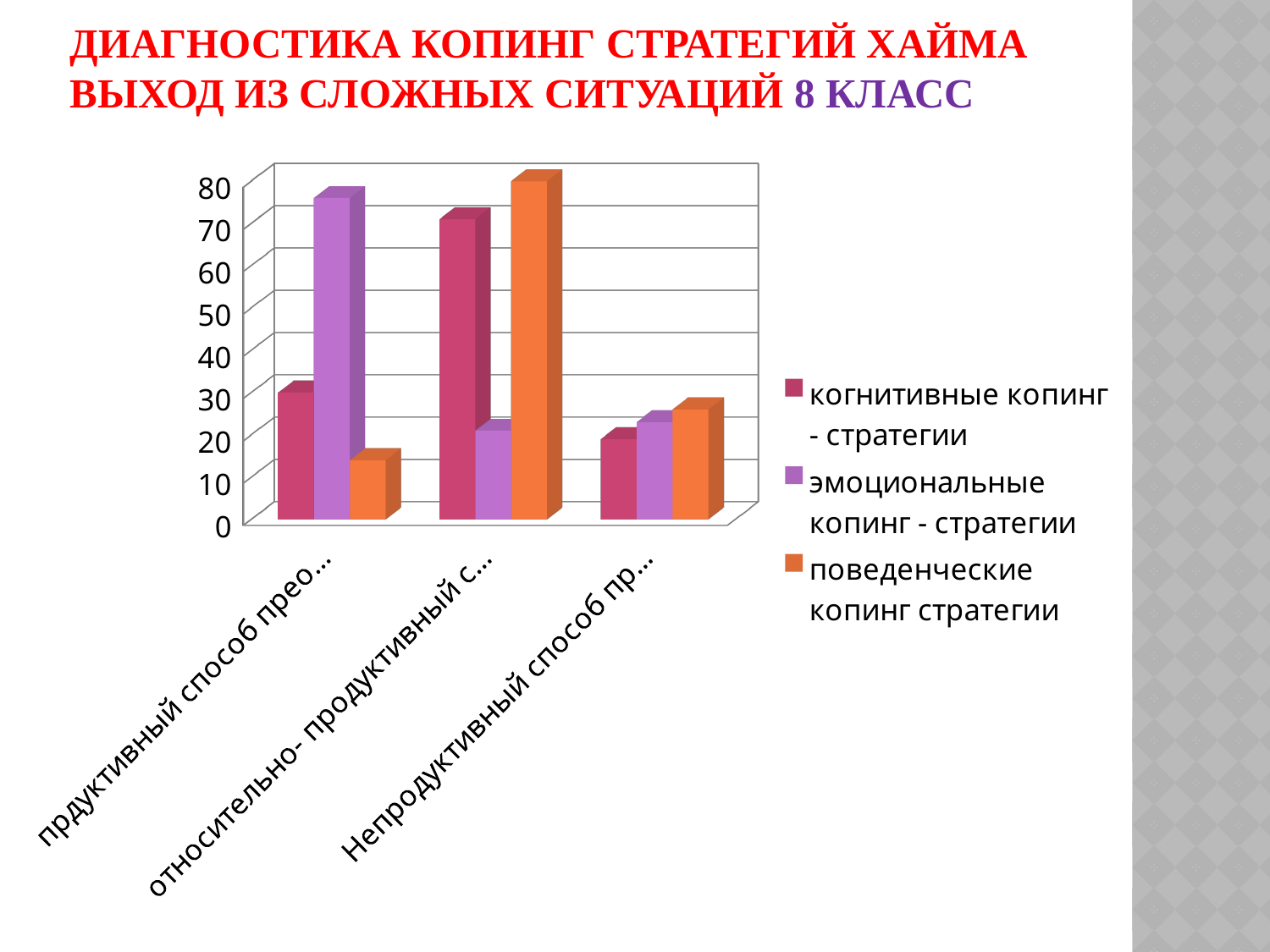
Is the value for 'поведенческие копинг стратегии' in the first category (прдуктивный способ прео...) greater or less than 20? less In the first category (прдуктивный способ прео...), which is larger: 'эмоциональные копинг - стратегии' or 'когнитивные копинг - стратегии'? эмоциональные копинг - стратегии For the series 'поведенческие копинг стратегии', which category has the highest bar? относительно- продуктивный с... (second category) Is the value for 'эмоциональные копинг - стратегии' in the first category (прдуктивный способ прео...) greater or less than 60? greater For the series 'поведенческие копинг стратегии', which category has the lowest bar? прдуктивный способ прео... (first category) In the second category (относительно- продуктивный с...), which is larger: 'поведенческие копинг стратегии' or 'эмоциональные копинг - стратегии'? поведенческие копинг стратегии How many series does the legend list? 3 What colour represents 'поведенческие копинг стратегии' in the legend? orange How many categories are shown along the x axis? 3 Is the value for 'когнитивные копинг - стратегии' in the second category (относительно- продуктивный с...) greater or less than 50? greater What kind of chart is shown on the slide? bar chart For the series 'когнитивные копинг - стратегии', which category has the highest bar? относительно- продуктивный с... (second category)